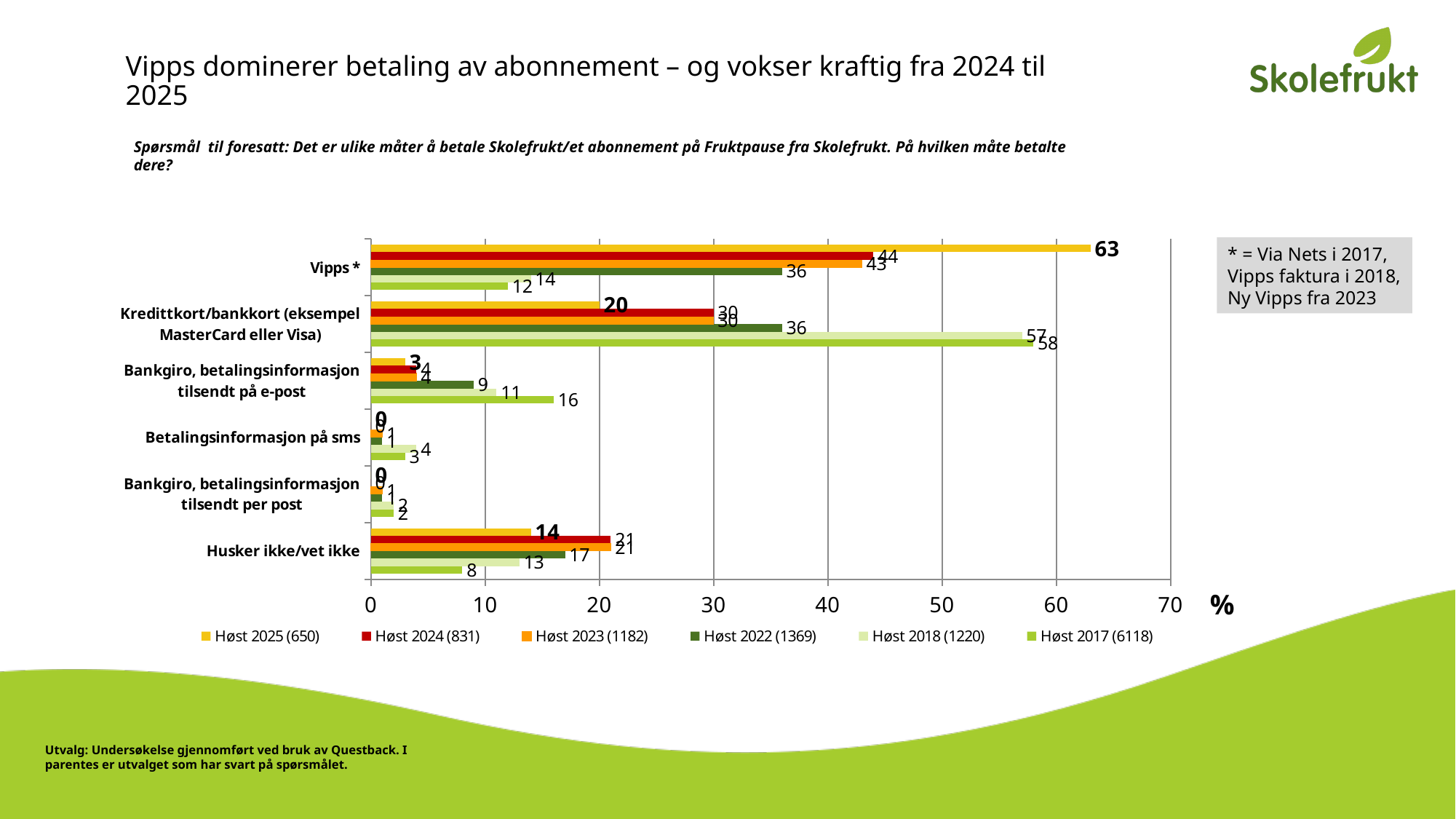
What is the difference between the Vipps * values for Høst 2025 and Høst 2024? 19 What is the value for Kredittkort/bankkort (eksempel MasterCard eller Visa) in Høst 2017? 58 How many payment-method categories are shown on the chart? 6 What is the value for Husker ikke/vet ikke in Høst 2017? 8 What kind of chart is shown on the slide? bar chart What is the value for Bankgiro, betalingsinformasjon tilsendt på e-post in Høst 2017? 16 For Husker ikke/vet ikke, which is larger: the Høst 2024 value or the Høst 2025 value? Høst 2024 What is the value for Vipps * in Høst 2025? 63 Is the value for Vipps * in Høst 2025 greater or less than 60? greater Which category has the highest value for Høst 2025? Vipps * What sample size is shown in the legend for Høst 2017? 6118 How many series does the legend list? 6